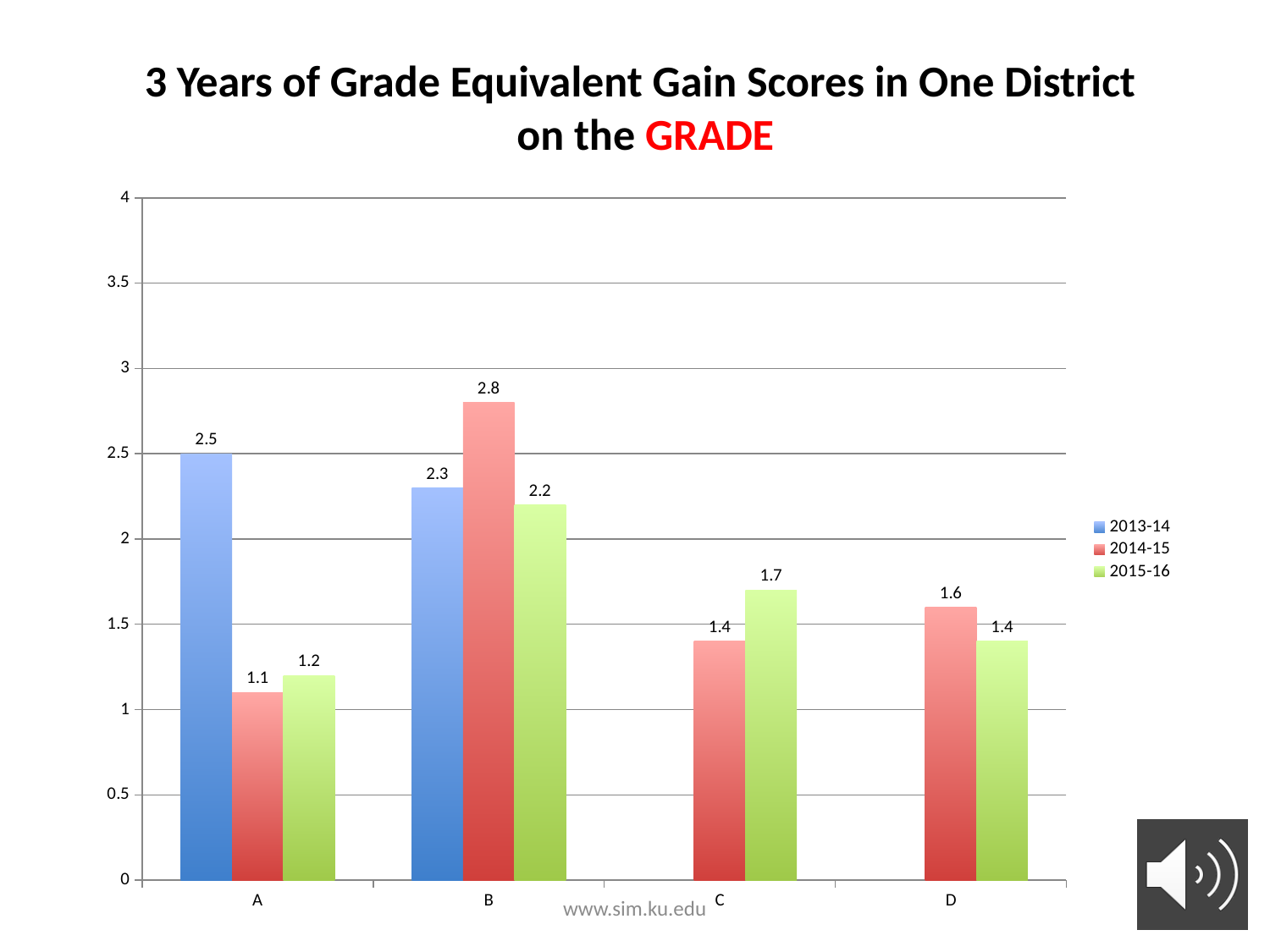
What kind of chart is shown on the slide? Bar chart What is the 2014-15 value for category B? 2.8 Which category has the lowest 2015-16 value? A What is the 2015-16 value for category C? 1.7 What is the 2013-14 value for category A? 2.5 How many categories are shown on the x axis? 4 Which is larger for category B: the 2013-14 value or the 2015-16 value? 2013-14 Which colour represents the 2015-16 series? Green Which category has the highest 2014-15 value? B How many series does the legend list? 3 What is the difference between the 2014-15 and 2015-16 values for category A? 0.1 What is the 2014-15 value for category D? 1.6